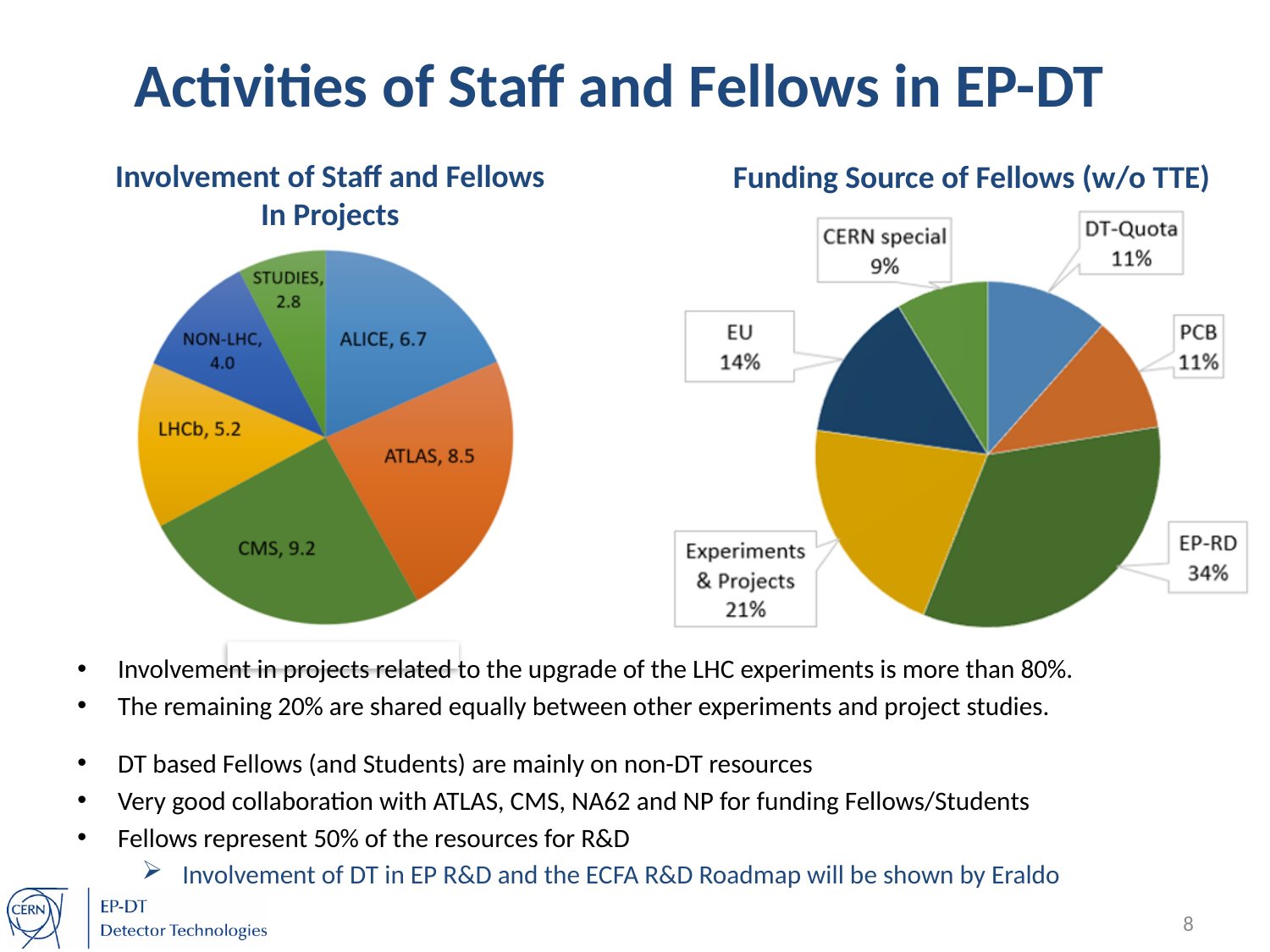
In the 'Involvement of Staff and Fellows In Projects' chart, which category has the largest value? CMS In the 'Funding Source of Fellows (w/o TTE)' chart, what is the percentage for EU? 14% In the 'Involvement of Staff and Fellows In Projects' chart, what is the difference between the ATLAS and ALICE values? 1.8 In the 'Funding Source of Fellows (w/o TTE)' chart, which is larger, Experiments & Projects or EU? Experiments & Projects In the 'Involvement of Staff and Fellows In Projects' chart, what is the value for LHCb? 5.2 In the 'Involvement of Staff and Fellows In Projects' chart, how many categories are shown? 6 In the 'Involvement of Staff and Fellows In Projects' chart, which category has the smallest value? STUDIES In the 'Funding Source of Fellows (w/o TTE)' chart, what share does EP-RD have? 34% In the 'Involvement of Staff and Fellows In Projects' chart, what is the value for CMS? 9.2 In the 'Funding Source of Fellows (w/o TTE)' chart, what is the difference between the EP-RD and DT-Quota shares? 23% In the 'Funding Source of Fellows (w/o TTE)' chart, which funding source has the smallest share? CERN special What type of chart is used for 'Funding Source of Fellows (w/o TTE)'? Pie chart